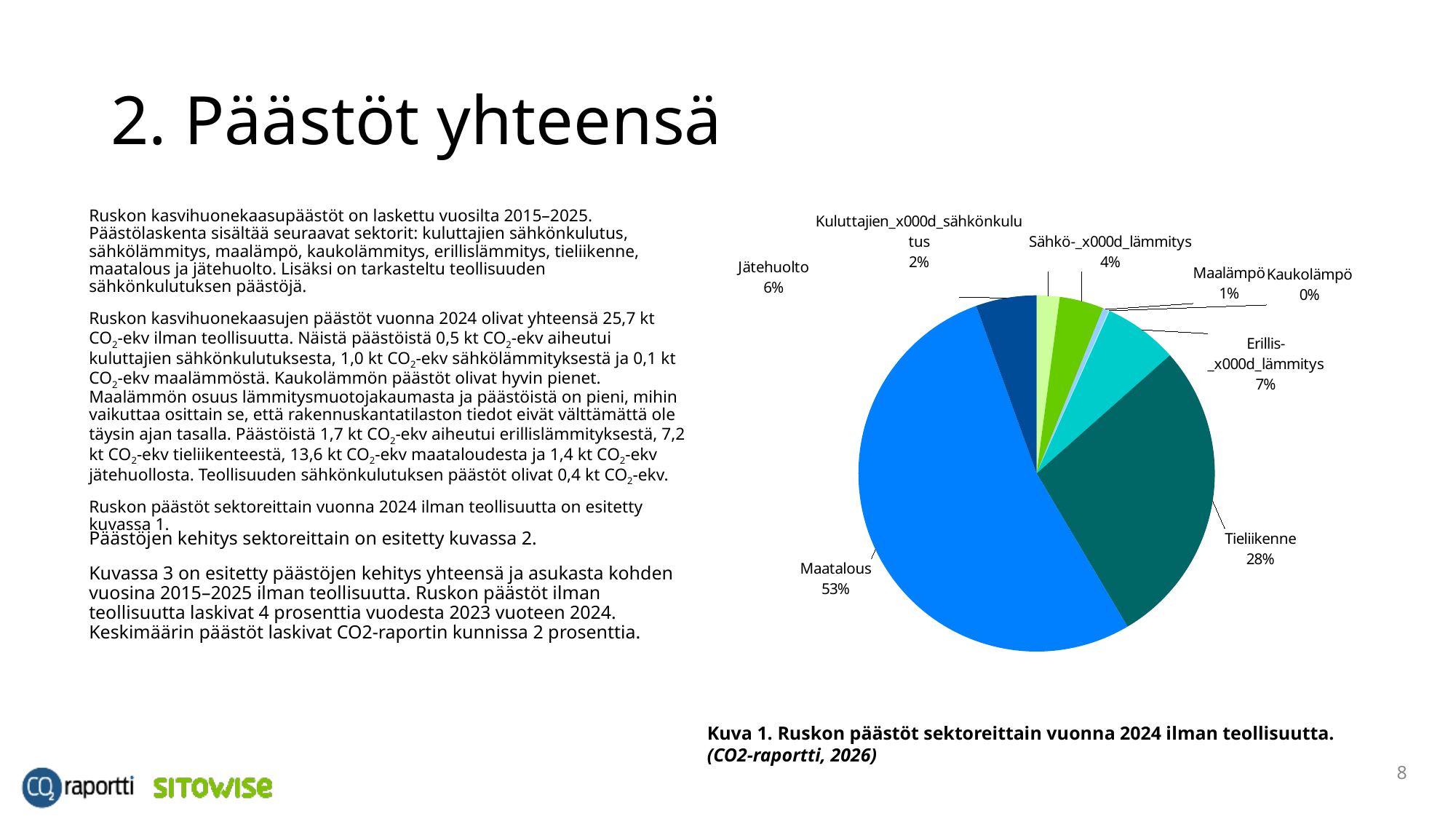
What is the value shown for Jätehuolto? 6% Which sector has the smallest share in the pie chart? Kaukolämpö What is the value shown for Erillislämmitys? 7% According to the caption, which year does the pie chart (Kuva 1) describe? 2024 What is the difference in percentage points between Maatalous and Tieliikenne? 25 What kind of chart is shown on the slide? pie chart Which is larger, the share for Sähkölämmitys or the share for Jätehuolto? Jätehuolto What is the value shown for Kaukolämpö? 0% What share of the pie does Tieliikenne have? 28% Which sector has the largest slice of the pie? Maatalous How many slices does the pie chart have? 8 What share of the pie does Maatalous have? 53%